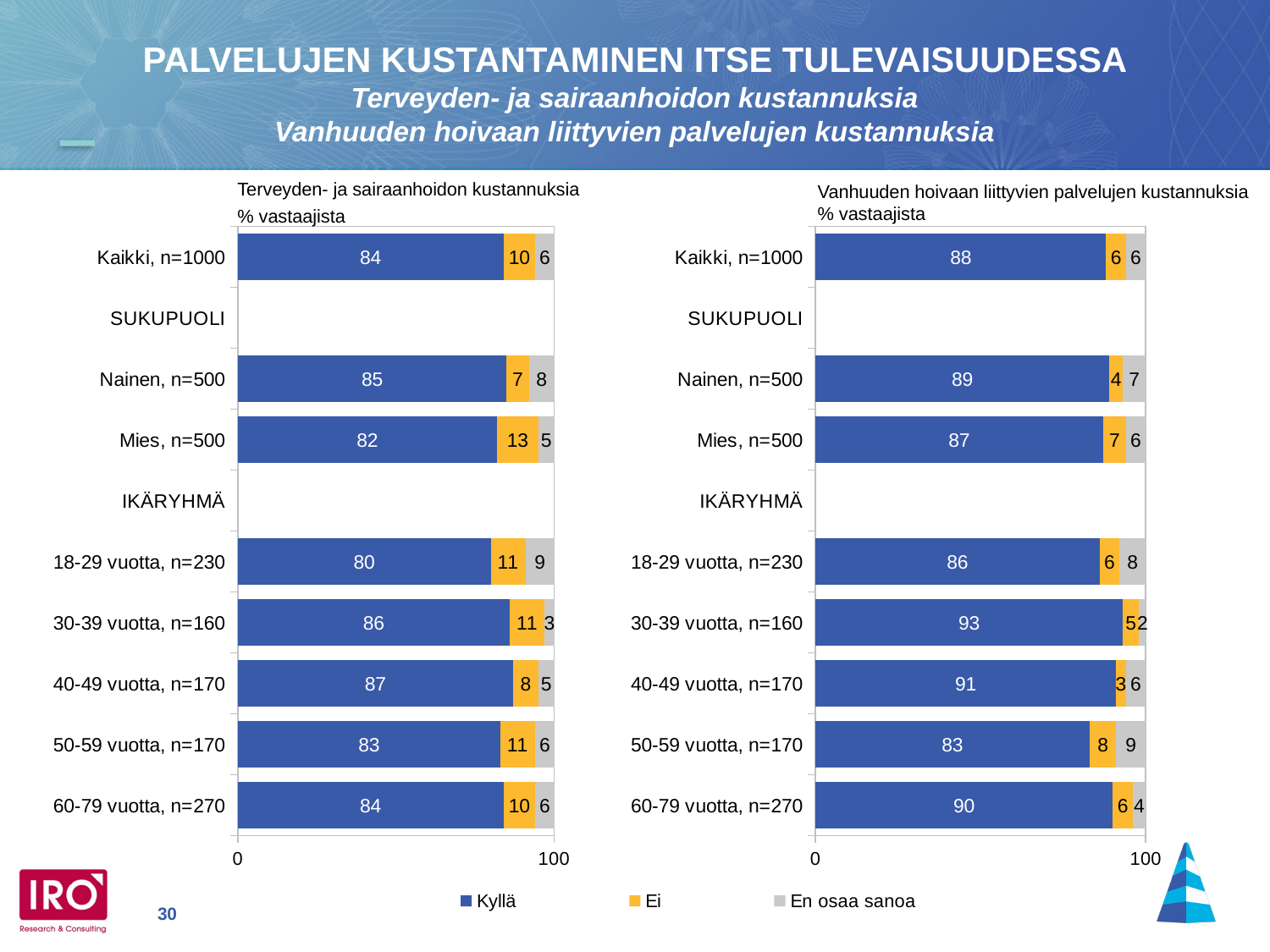
In the left chart (Terveyden- ja sairaanhoidon kustannuksia), what is the total of the stacked bar for 18-29 vuotta, n=230? 100 In the right chart (Vanhuuden hoivaan liittyvien palvelujen kustannuksia), what is the Kyllä value for 30-39 vuotta, n=160? 93 In the left chart (Terveyden- ja sairaanhoidon kustannuksia), what is the Kyllä value for Kaikki, n=1000? 84 In the left chart (Terveyden- ja sairaanhoidon kustannuksia), what is the difference between the Kyllä values for Nainen, n=500 and Mies, n=500? 3 In the left chart (Terveyden- ja sairaanhoidon kustannuksia), which category has the highest Kyllä value? 40-49 vuotta, n=170 In the right chart (Vanhuuden hoivaan liittyvien palvelujen kustannuksia), which category has the lowest Kyllä value? 50-59 vuotta, n=170 How many series does the legend list? 3 Which legend entry is shown in orange? Ei What kind of chart is shown on the left of the slide? Stacked bar chart In the right chart (Vanhuuden hoivaan liittyvien palvelujen kustannuksia), what is the En osaa sanoa value for 50-59 vuotta, n=170? 9 In the left chart (Terveyden- ja sairaanhoidon kustannuksia), what is the Ei value for Mies, n=500? 13 In the right chart (Vanhuuden hoivaan liittyvien palvelujen kustannuksia), which has the larger Kyllä value: 18-29 vuotta, n=230 or 60-79 vuotta, n=270? 60-79 vuotta, n=270